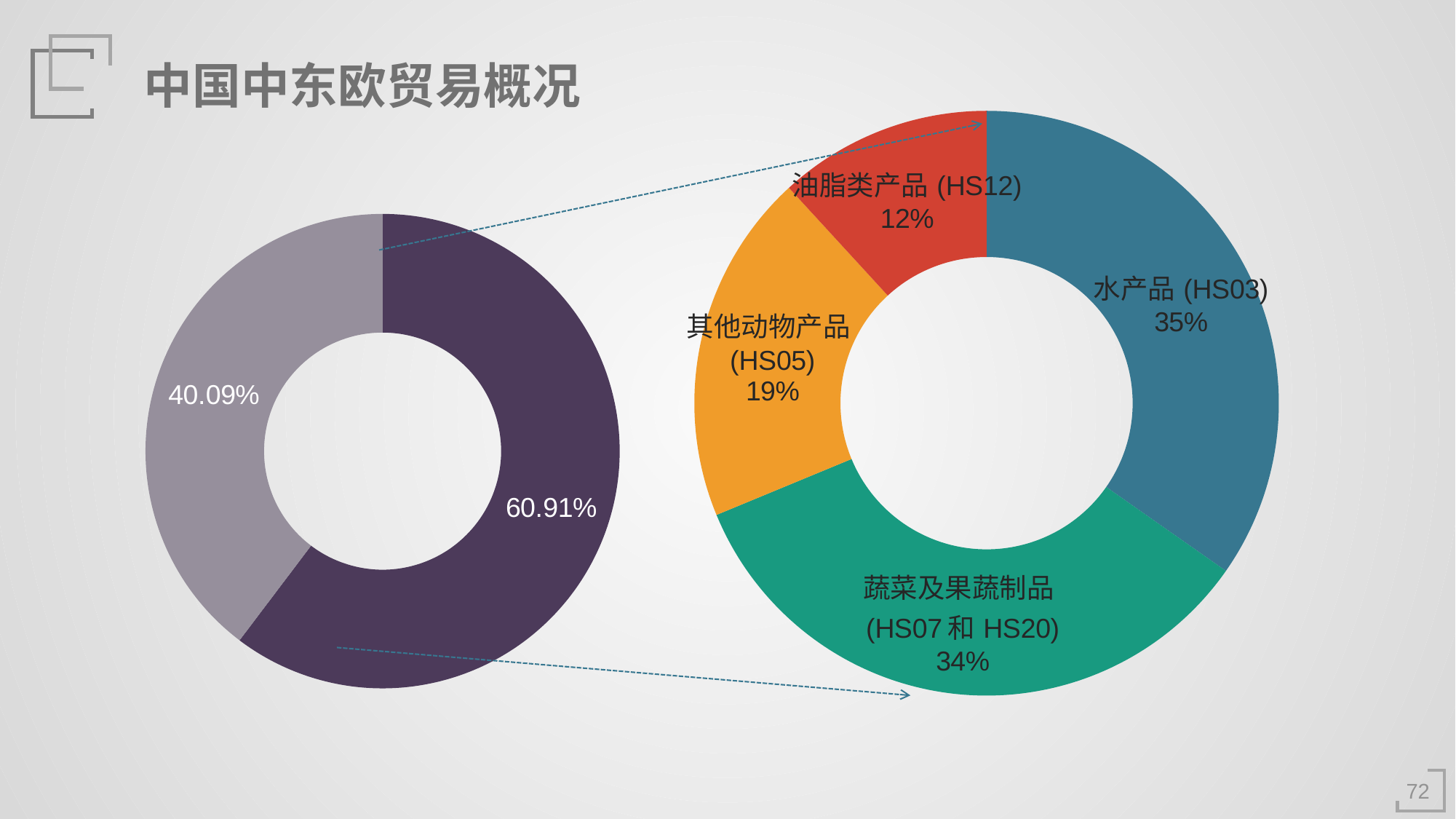
In the chart on the right, which category has the smallest share? 油脂类产品 (HS12) In the chart on the right, what share is shown for 蔬菜及果蔬制品 (HS07 和 HS20)? 34% How many categories does the chart on the right show? 4 In the chart on the left, what value is shown on the dark purple slice? 60.91% In the chart on the left, what value is shown on the grey slice? 40.09% In the chart on the right, which category has the largest share? 水产品 (HS03) In the chart on the right, what share is shown for 油脂类产品 (HS12)? 12% In the chart on the right, what share is shown for 水产品 (HS03)? 35% In the chart on the right, what is the difference in percentage points between 水产品 (HS03) and 其他动物产品 (HS05)? 16 In the chart on the left, what is the difference in percentage points between the two slices? 20.82 In the chart on the right, what share is shown for 其他动物产品 (HS05)? 19% What kind of chart is the chart on the right of the slide? Donut (pie) chart